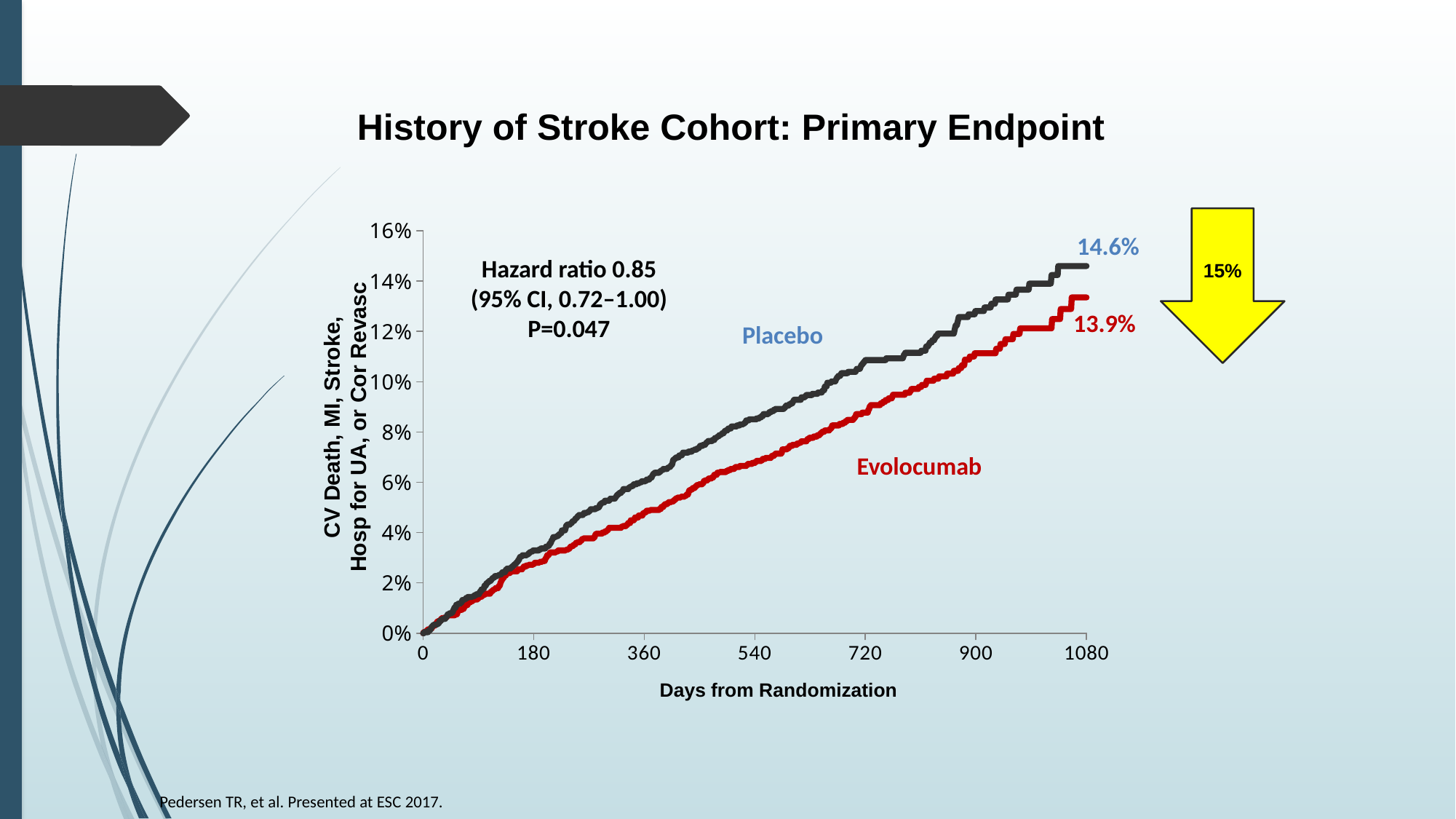
What is the final event rate shown for the Placebo group? 14.6% Do the event rates rise or fall as days from randomization increase? Rise Is the Evolocumab event rate at day 900 greater or less than 8%? greater Which group has the higher event rate at the end of follow-up, Placebo or Evolocumab? Placebo What percentage is shown inside the yellow arrow? 15% How many treatment groups (series) are plotted on the chart? 2 What is the difference between the final Placebo and Evolocumab event rates? 0.7% Is the Placebo event rate at day 540 greater or less than 10%? less What hazard ratio is reported on the chart? 0.85 What is the label of the x axis? Days from Randomization What kind of chart is shown on the slide? Line chart What is the final event rate shown for the Evolocumab group? 13.9%